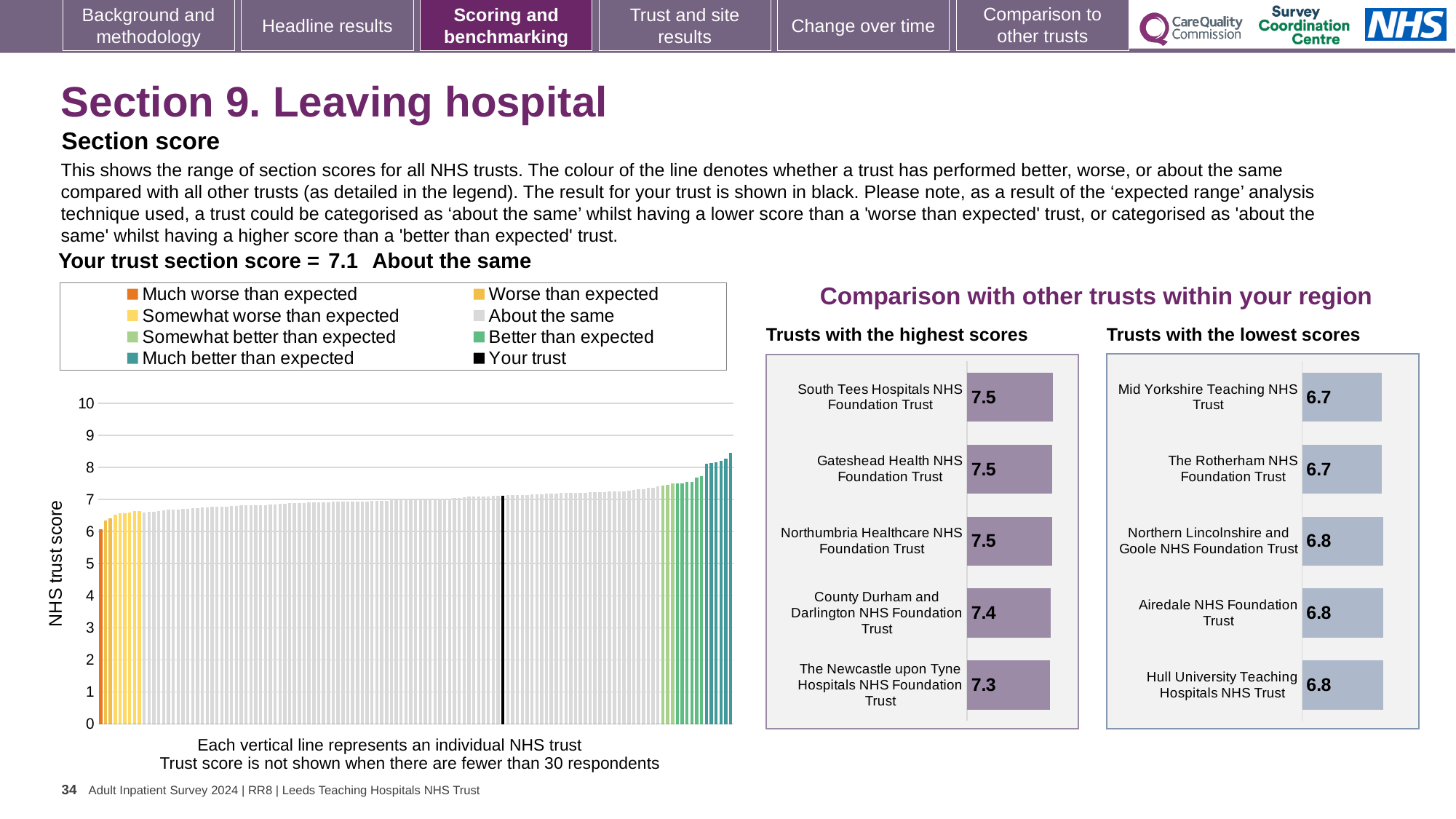
How many entries does the legend above the large chart on the left list? 8 In the large chart on the left, do the trust scores rise or fall from left to right? rise In the 'Trusts with the highest scores' chart, what is the score for County Durham and Darlington NHS Foundation Trust? 7.4 How many trusts are shown in the 'Trusts with the lowest scores' chart? 5 In the large chart on the left, what is the section score for your trust? 7.1 In the large chart on the left, is the value of the highest bar greater or less than 9? less In the 'Trusts with the highest scores' chart, which trust has the lowest score? The Newcastle upon Tyne Hospitals NHS Foundation Trust What kind of chart is the large chart on the left showing NHS trust scores? bar chart What is the y-axis label of the large chart on the left? NHS trust score In the 'Trusts with the highest scores' chart, what is the difference between the scores of South Tees Hospitals NHS Foundation Trust and The Newcastle upon Tyne Hospitals NHS Foundation Trust? 0.2 In the 'Trusts with the lowest scores' chart, what is the score for Airedale NHS Foundation Trust? 6.8